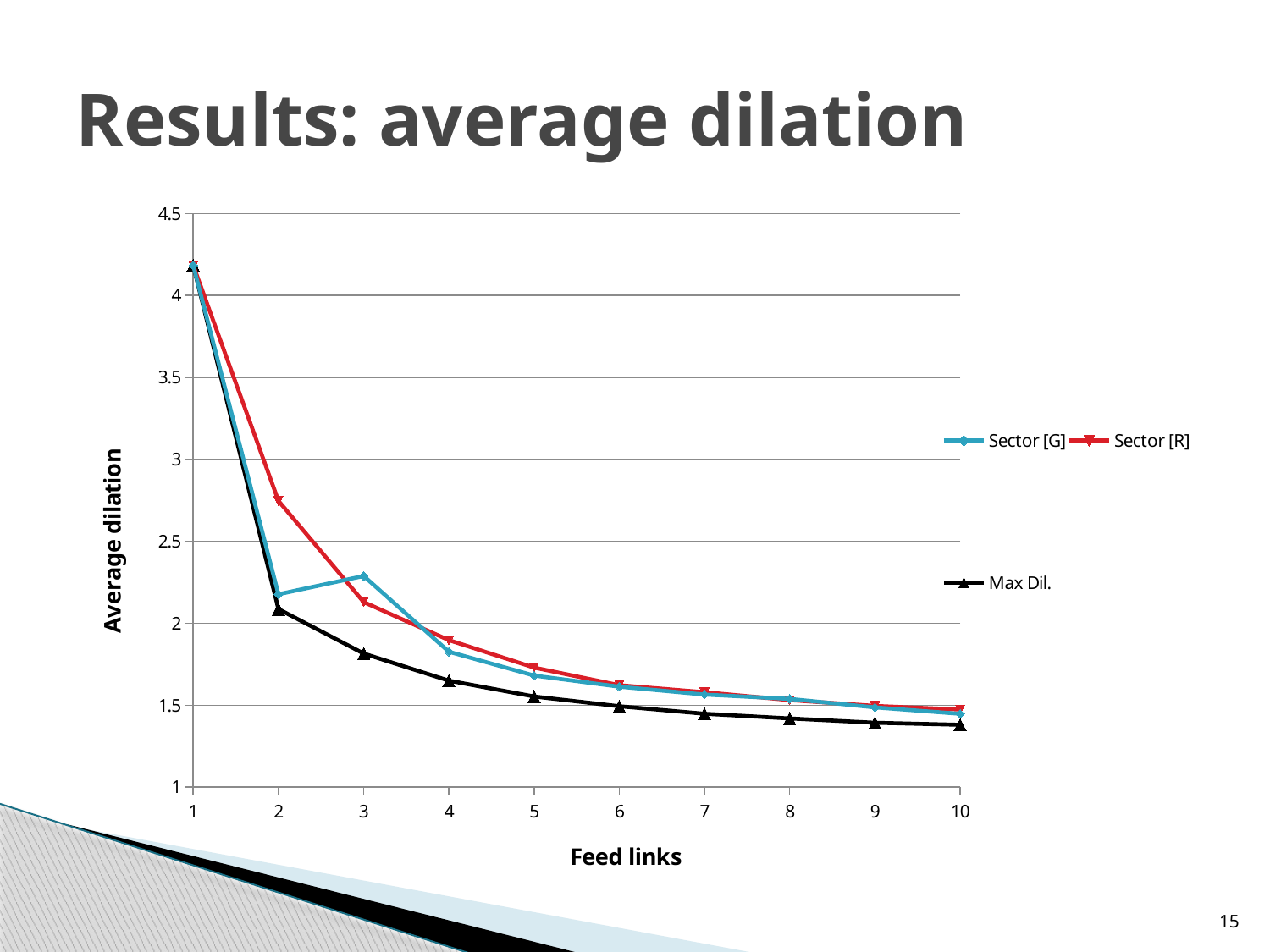
At 2 feed links, which is larger: Sector [G] or Sector [R]? Sector [R] How many feed link values are plotted along the x axis? 10 Is the value for Sector [G] at 1 feed link greater or less than 4? greater Is the value for Sector [G] at 3 feed links greater or less than 2? greater Is the value for Sector [R] at 2 feed links greater or less than 2.5? greater How many series does the legend list? 3 What is the title of the x axis? Feed links At which number of feed links is the Max Dil. value highest? 1 At 3 feed links, which is larger: Sector [G] or Sector [R]? Sector [G] Do the Max Dil. values rise or fall as the number of feed links increases? fall What kind of chart is shown on the slide? line chart